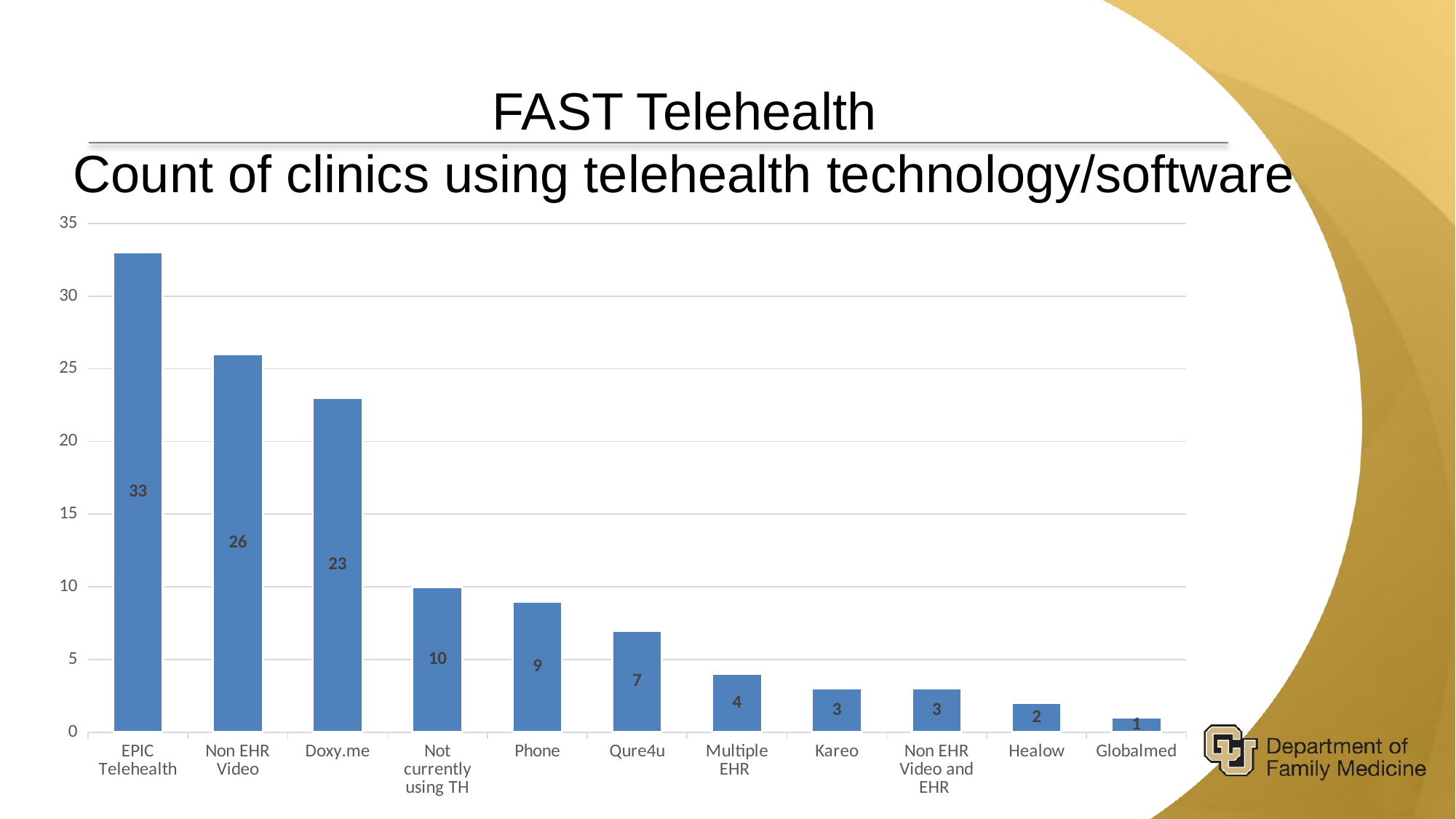
How many categories are shown on the x axis? 11 What kind of chart is shown on the slide? Bar chart Do the values rise or fall from left to right along the x axis? Fall Which category has the highest count of clinics? EPIC Telehealth Is the value for Non EHR Video greater or less than 25? greater How many clinics use EPIC Telehealth? 33 What is the difference between the counts for EPIC Telehealth and Non EHR Video? 7 Which category has the lowest count of clinics? Globalmed How many clinics are not currently using TH? 10 Which has a higher count of clinics, Multiple EHR or Healow? Multiple EHR What is the count of clinics for Doxy.me? 23 What is the difference between the counts for Phone and Qure4u? 2